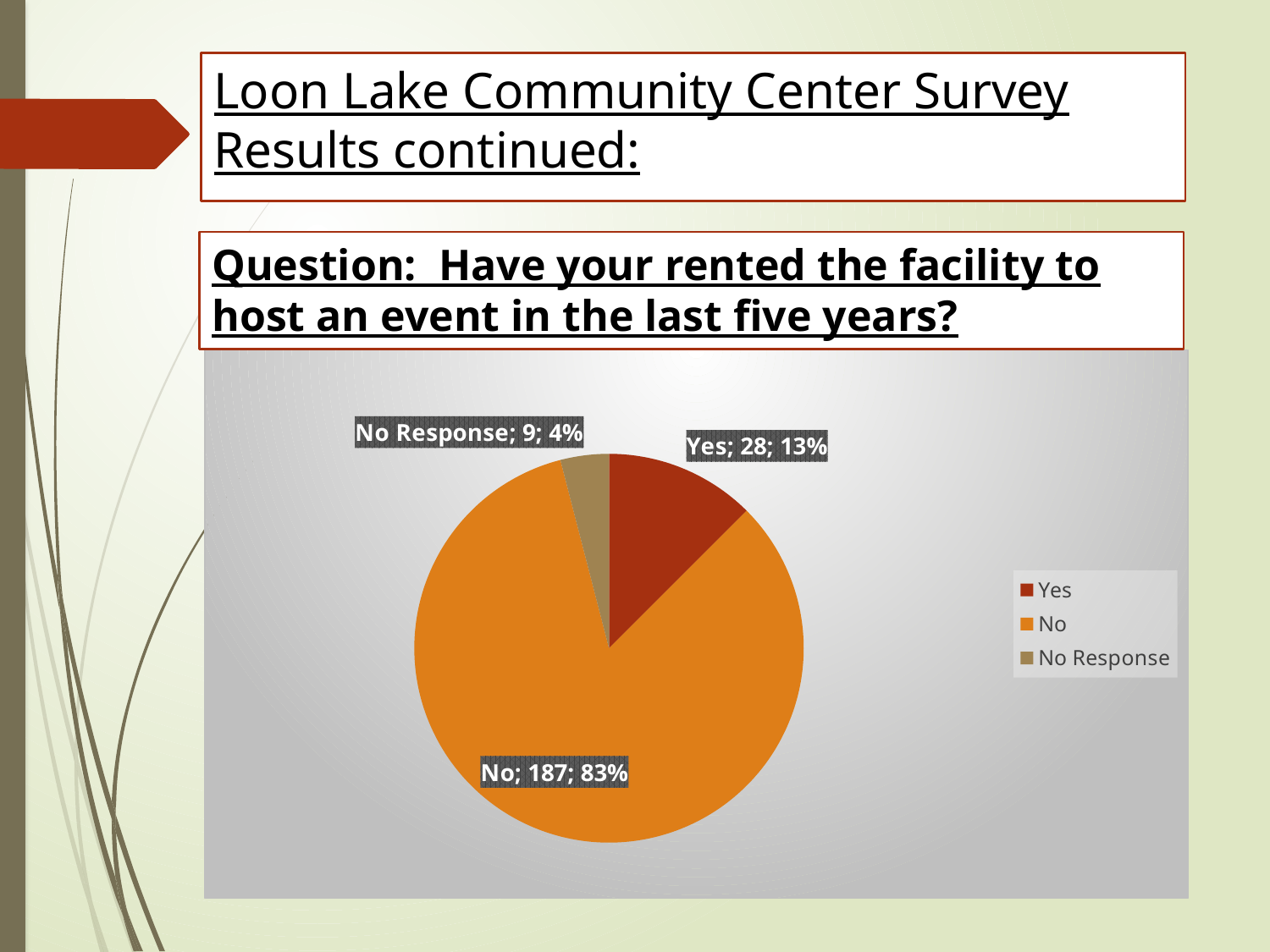
What percentage of the pie does the "No" slice represent? 83% How many respondents answered "Yes"? 28 How many respondents gave "No Response"? 9 What percentage of the pie does the "Yes" slice represent? 13% How many categories does the legend list? 3 What is the difference between the number of "No" and "Yes" responses? 159 What kind of chart is shown on the slide? pie chart What colour is the "No" slice? orange How many respondents answered "No"? 187 What percentage of the pie does the "No Response" slice represent? 4% Which response category has the largest slice? No Which response category has the smallest slice? No Response